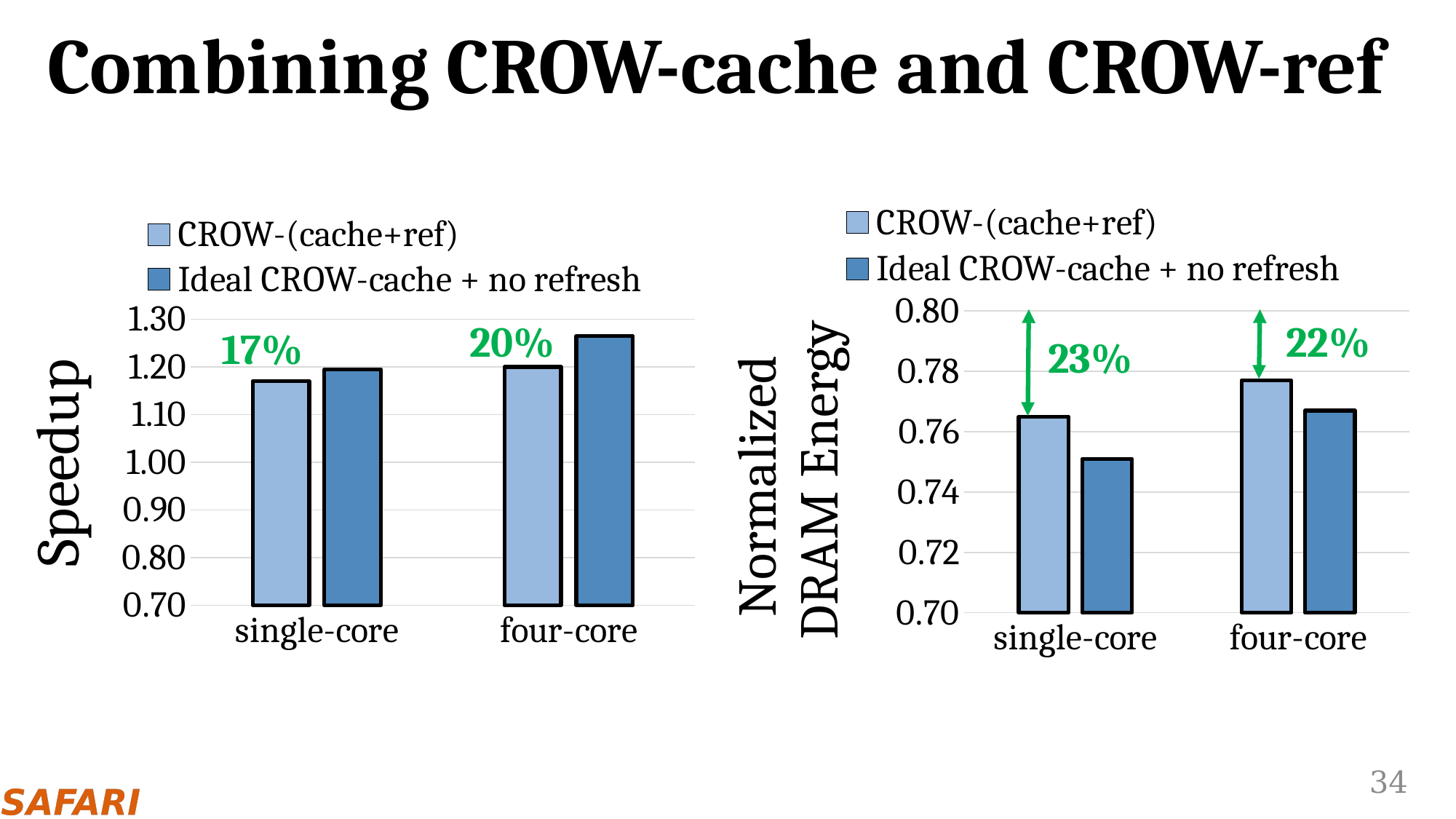
In the Speedup chart, which bar is the highest? Ideal CROW-cache + no refresh, four-core In the Normalized DRAM Energy chart, for single-core, which series has the larger value: CROW-(cache+ref) or Ideal CROW-cache + no refresh? CROW-(cache+ref) How many categories are shown on the x axis of the Speedup chart? 2 In the Speedup chart, is the single-core value for CROW-(cache+ref) greater or less than 1.10? greater What kind of chart is the Speedup chart on the left? bar chart In the Speedup chart, does the CROW-(cache+ref) value rise or fall from single-core to four-core? rise In the Normalized DRAM Energy chart, is the four-core value for CROW-(cache+ref) greater or less than 0.76? greater How many series does the legend of the Normalized DRAM Energy chart list? 2 In the Normalized DRAM Energy chart, which bar is the lowest? Ideal CROW-cache + no refresh, single-core What percentage is annotated above the four-core bars in the Speedup chart? 20% In the Speedup chart, is the four-core value for Ideal CROW-cache + no refresh greater or less than 1.20? greater